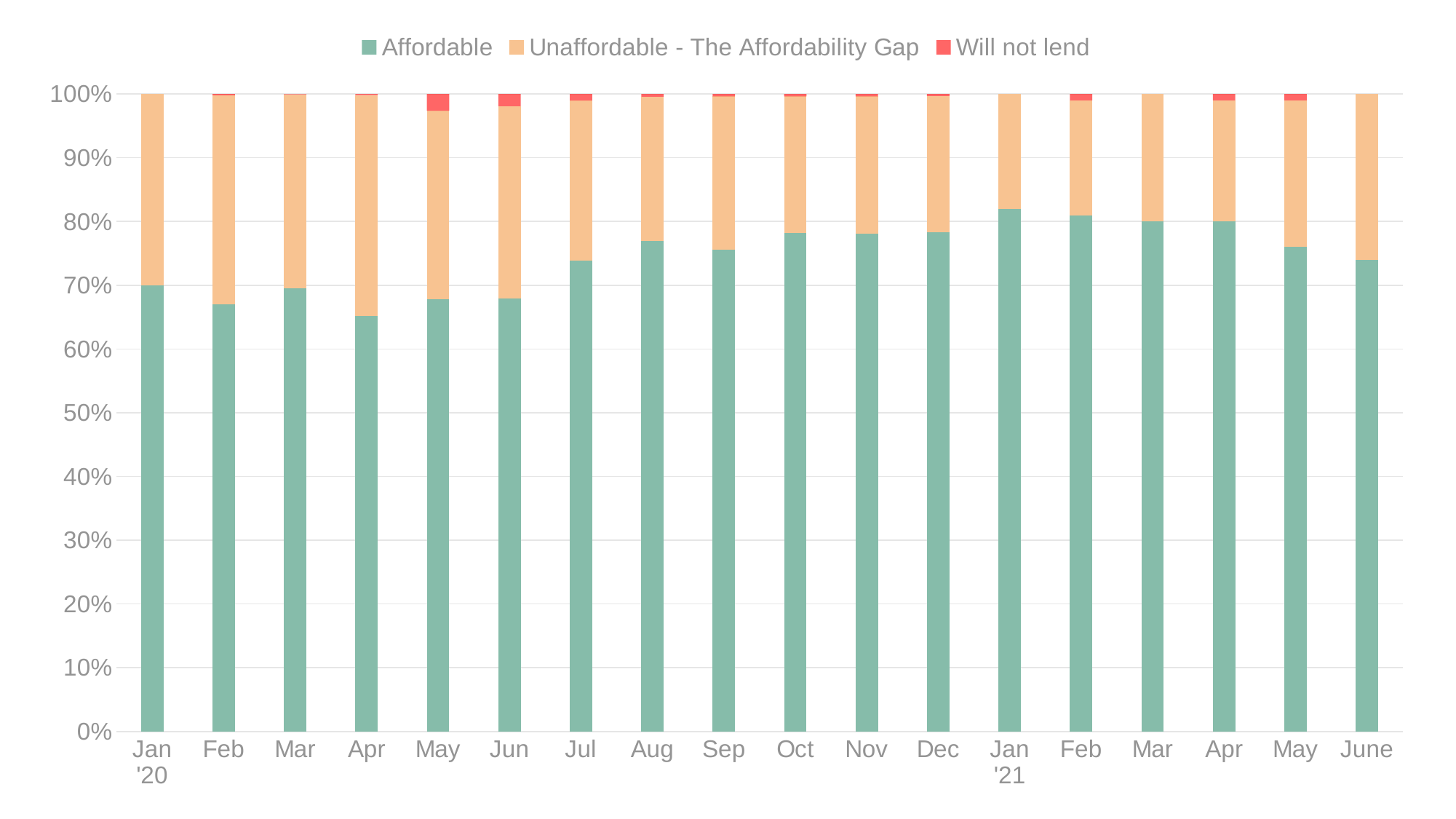
What does each stacked bar total? 100% How many series does the legend list? 3 Is the Affordable value for Apr '20 greater or less than 70%? less Is the Affordable value for Jan '21 greater or less than 80%? greater Does the Affordable share rise or fall overall from Jan '20 to Jan '21? rise Which colour represents the 'Will not lend' series in the legend? Red Which has the larger Affordable share, Apr '20 or Jan '21? Jan '21 Is the Affordable value for Aug '20 greater or less than 80%? less What kind of chart is shown on the slide? Stacked bar chart How many months are plotted along the x axis? 18 Which month has the lowest Affordable share? Apr '20